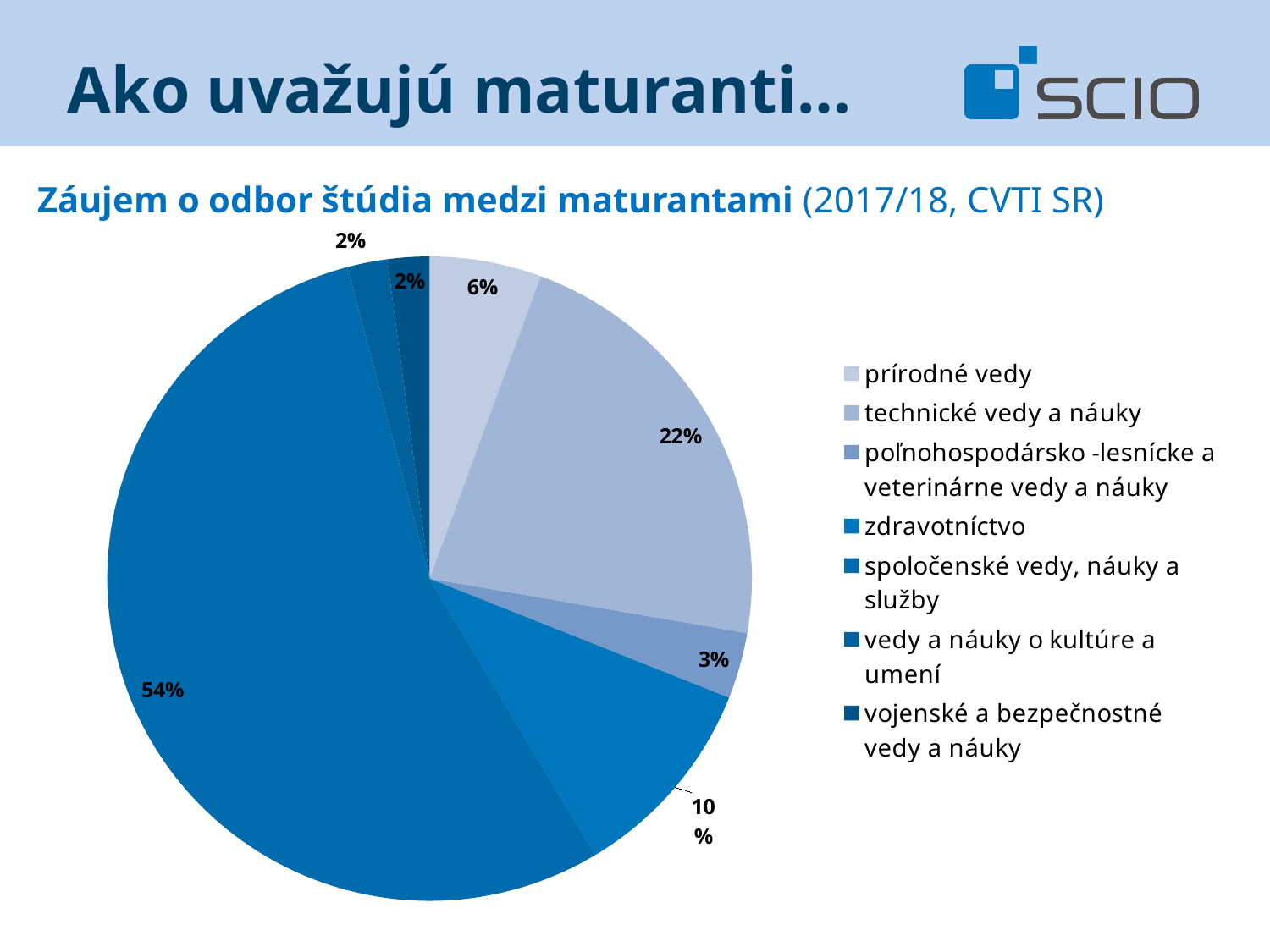
What is the value for 'vojenské a bezpečnostné vedy a náuky'? 2% What is the value for 'poľnohospodársko -lesnícke a veterinárne vedy a náuky'? 3% How many categories does the legend list? 7 Which category has the largest share of the pie? spoločenské vedy, náuky a služby What kind of chart is shown on the slide? pie chart What is the value for 'prírodné vedy'? 6% What share of the pie does 'technické vedy a náuky' have? 22% What is the value for 'zdravotníctvo'? 10% What share of the pie does 'spoločenské vedy, náuky a služby' have? 54% Which is larger, 'technické vedy a náuky' or 'zdravotníctvo'? technické vedy a náuky What is the difference between the shares of 'spoločenské vedy, náuky a služby' and 'technické vedy a náuky'? 32% What is the title of the chart? Záujem o odbor štúdia medzi maturantami (2017/18, CVTI SR)